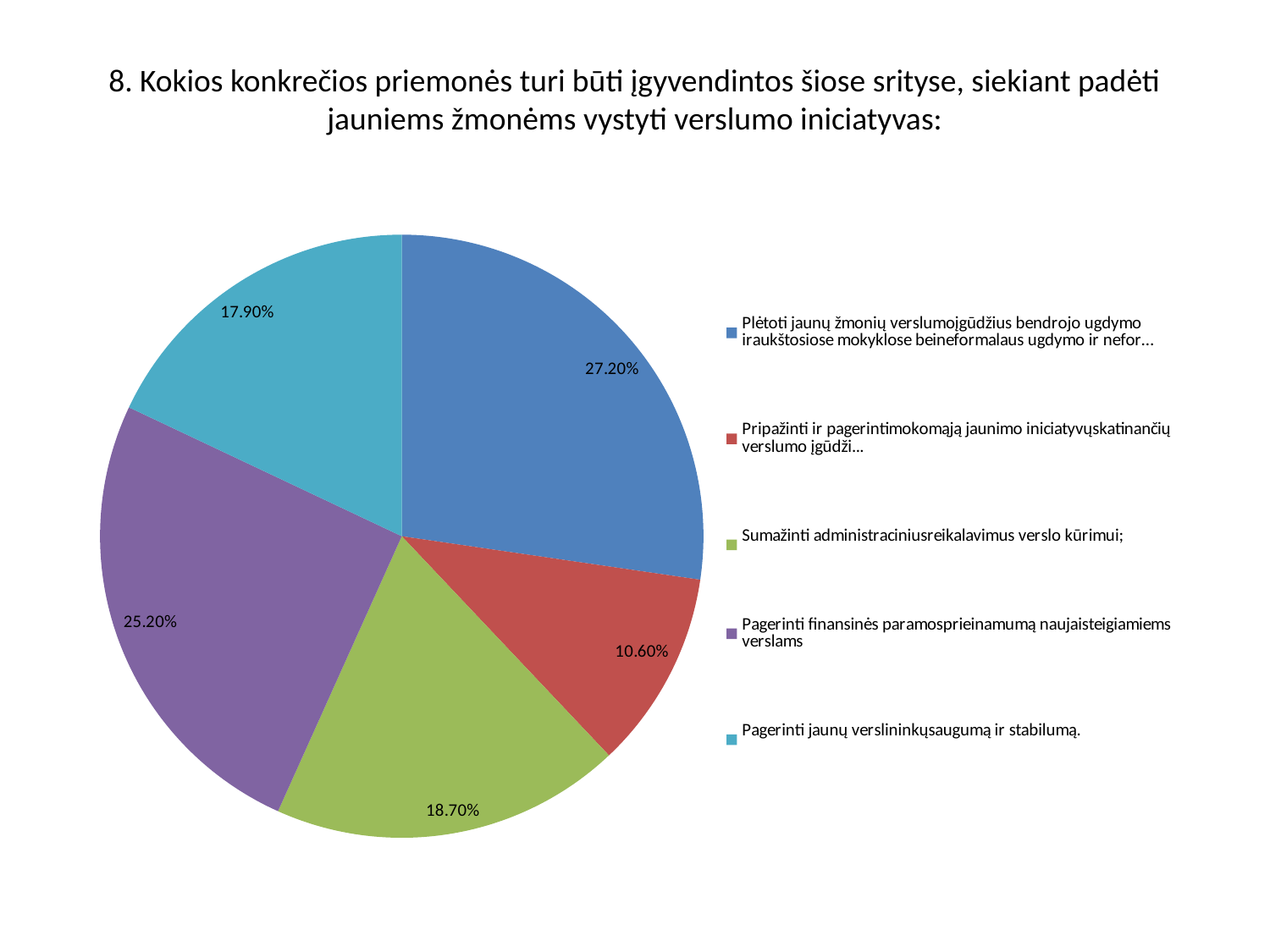
What colour is the slice representing "Pagerinti finansinės paramos prieinamumą naujai steigiamiems verslams"? purple Which slice has the largest share of the pie? Plėtoti jaunų žmonių verslumo įgūdžius bendrojo ugdymo ir aukštosiose mokyklose... How many slices does the pie chart have? 5 What percentage is shown for the slice "Pagerinti jaunų verslininkų saugumą ir stabilumą"? 17.90% How many entries does the legend list? 5 What kind of chart is shown on the slide? pie chart What percentage is shown for the slice "Sumažinti administracinius reikalavimus verslo kūrimui"? 18.70% What is the difference in percentage points between the largest slice (27.20%) and the smallest slice (10.60%)? 16.60 Which slice has the smallest share of the pie? Pripažinti ir pagerinti mokomąją jaunimo iniciatyvų skatinančių verslumo įgūdži... What percentage is shown for the slice beginning "Pripažinti ir pagerinti mokomąją jaunimo iniciatyvų"? 10.60% What percentage is shown for the slice "Pagerinti finansinės paramos prieinamumą naujai steigiamiems verslams"? 25.20% Which is larger: the share for "Sumažinti administracinius reikalavimus verslo kūrimui" or the share for "Pagerinti jaunų verslininkų saugumą ir stabilumą"? Sumažinti administracinius reikalavimus verslo kūrimui